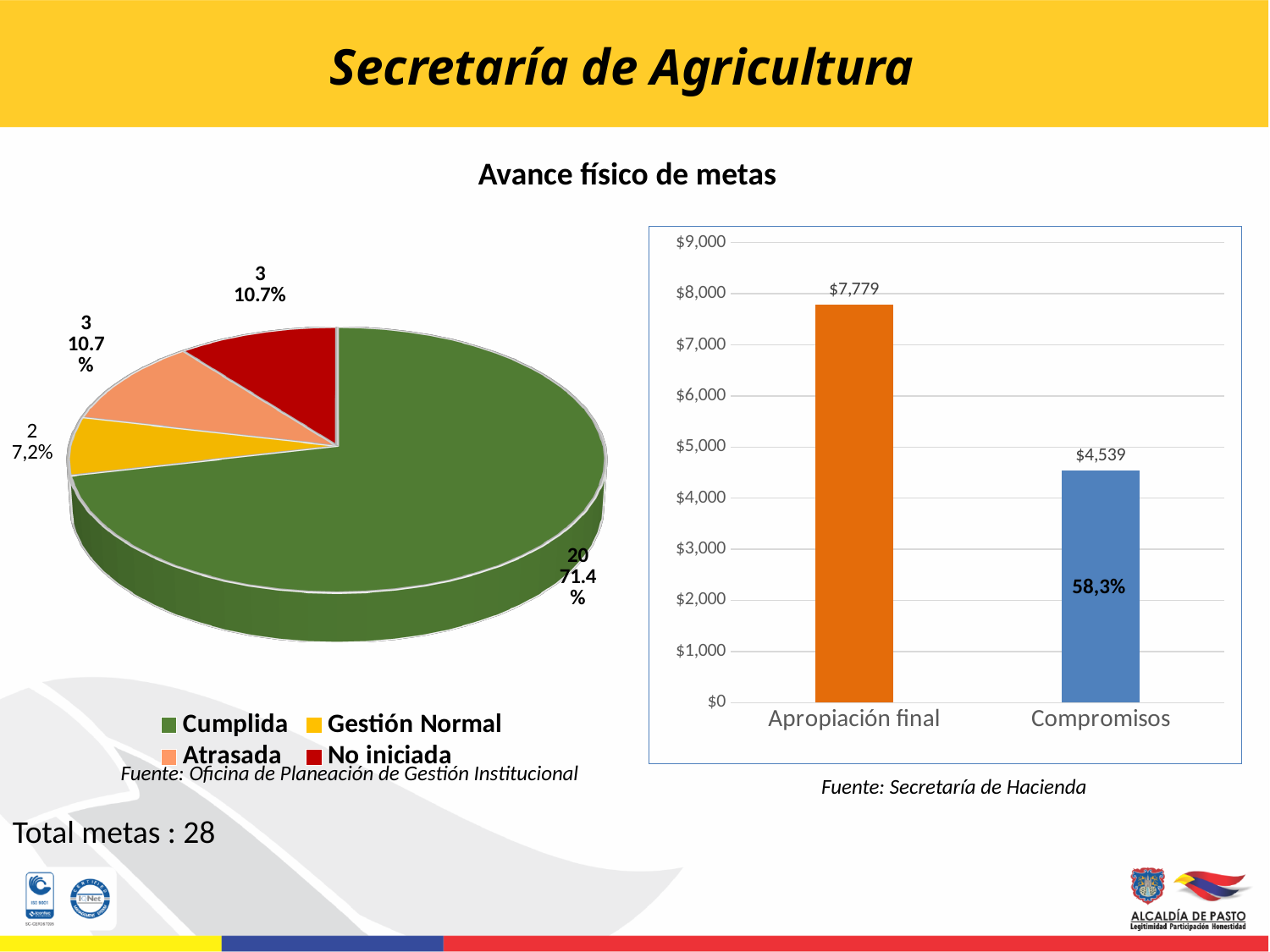
What kind of chart is the chart on the right of the slide? Bar chart In the pie chart on the left, what percentage is shown for Gestión Normal? 7,2% In the bar chart on the right, what is the difference between Apropiación final and Compromisos? $3,240 How many categories does the legend of the pie chart on the left list? 4 In the bar chart on the right, what is the value for Apropiación final? $7,779 In the pie chart on the left, how many metas are labelled Cumplida? 20 In the pie chart on the left, which category has the largest slice? Cumplida In the pie chart on the left, what percentage share does the Cumplida slice have? 71.4% What kind of chart is the chart on the left of the slide? Pie chart In the bar chart on the right, what is the value for Compromisos? $4,539 In the bar chart on the right, what percentage label is printed on the Compromisos bar? 58,3% In the pie chart on the left, which category has the smallest slice? Gestión Normal